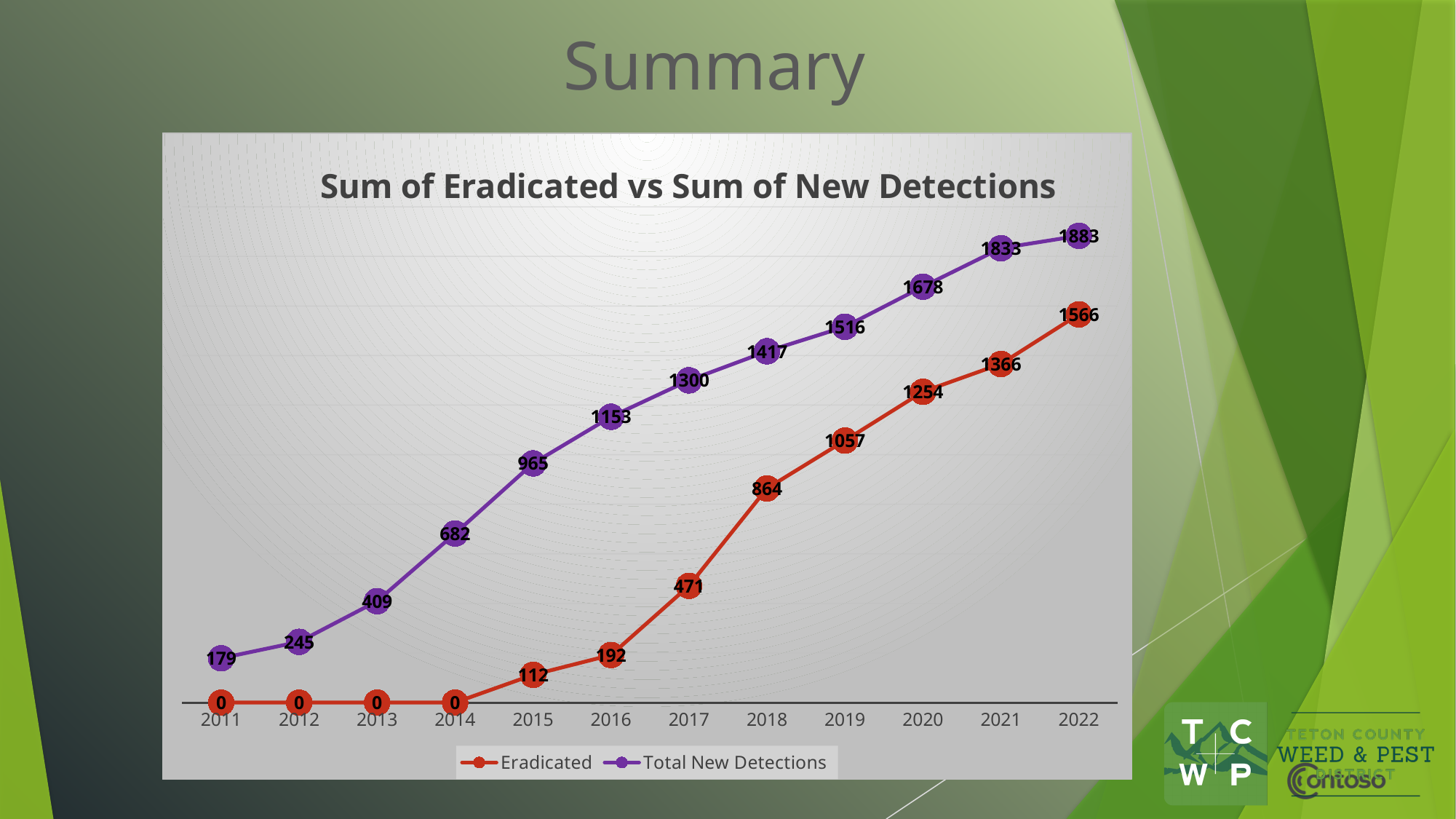
What is the value for Eradicated in 2015? 112 How many series does the legend list? 2 How many years are shown on the x axis? 12 Which year has the highest value for Total New Detections? 2022 What is the value for Eradicated in 2018? 864 What is the difference between Eradicated in 2021 and Eradicated in 2020? 112 Do the Total New Detections values rise or fall from 2011 to 2022? rise What is the difference between Total New Detections and Eradicated in 2022? 317 Which is larger in 2016: Eradicated or Total New Detections? Total New Detections What kind of chart is shown? line chart Which year has the lowest value for Total New Detections? 2011 What is the value for Total New Detections in 2017? 1300